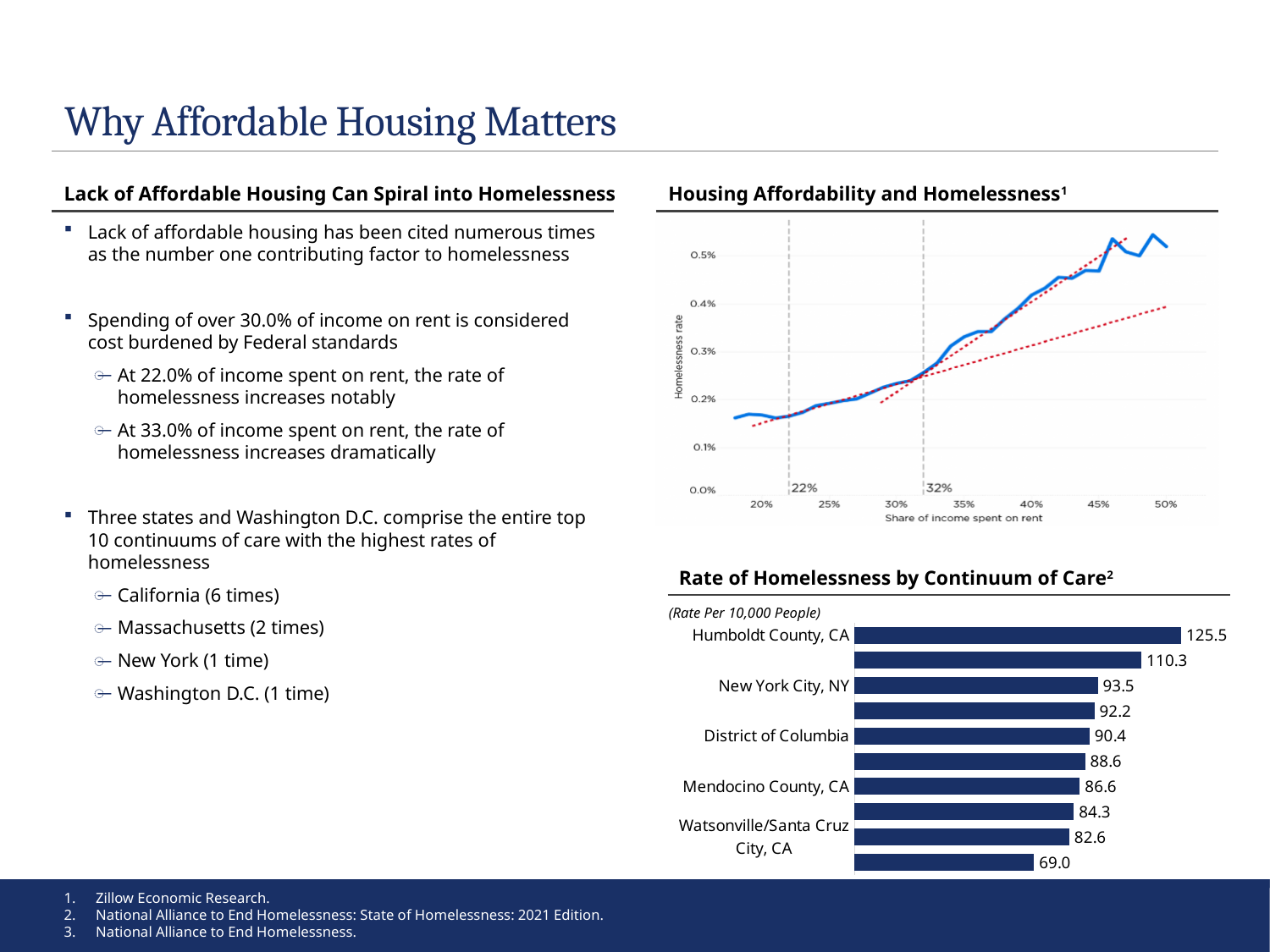
In 'Rate of Homelessness by Continuum of Care', what is the rate for Humboldt County, CA? 125.5 In 'Rate of Homelessness by Continuum of Care', what is the difference between the rates for Humboldt County, CA and New York City, NY? 32.0 In 'Rate of Homelessness by Continuum of Care', what is the rate for District of Columbia? 90.4 What kind of chart is 'Rate of Homelessness by Continuum of Care'? bar chart In 'Rate of Homelessness by Continuum of Care', which continuum of care has the highest rate? Humboldt County, CA In 'Housing Affordability and Homelessness', is the homelessness rate at a 45% share of income spent on rent greater or less than 0.4%? greater What kind of chart is 'Housing Affordability and Homelessness'? line chart In 'Housing Affordability and Homelessness', does the homelessness rate rise or fall as the share of income spent on rent increases? rises In 'Rate of Homelessness by Continuum of Care', which has a higher rate: District of Columbia or Mendocino County, CA? District of Columbia How many bars are plotted in 'Rate of Homelessness by Continuum of Care'? 10 In 'Rate of Homelessness by Continuum of Care', what is the rate for Watsonville/Santa Cruz City, CA? 82.6 In 'Rate of Homelessness by Continuum of Care', what is the rate for New York City, NY? 93.5